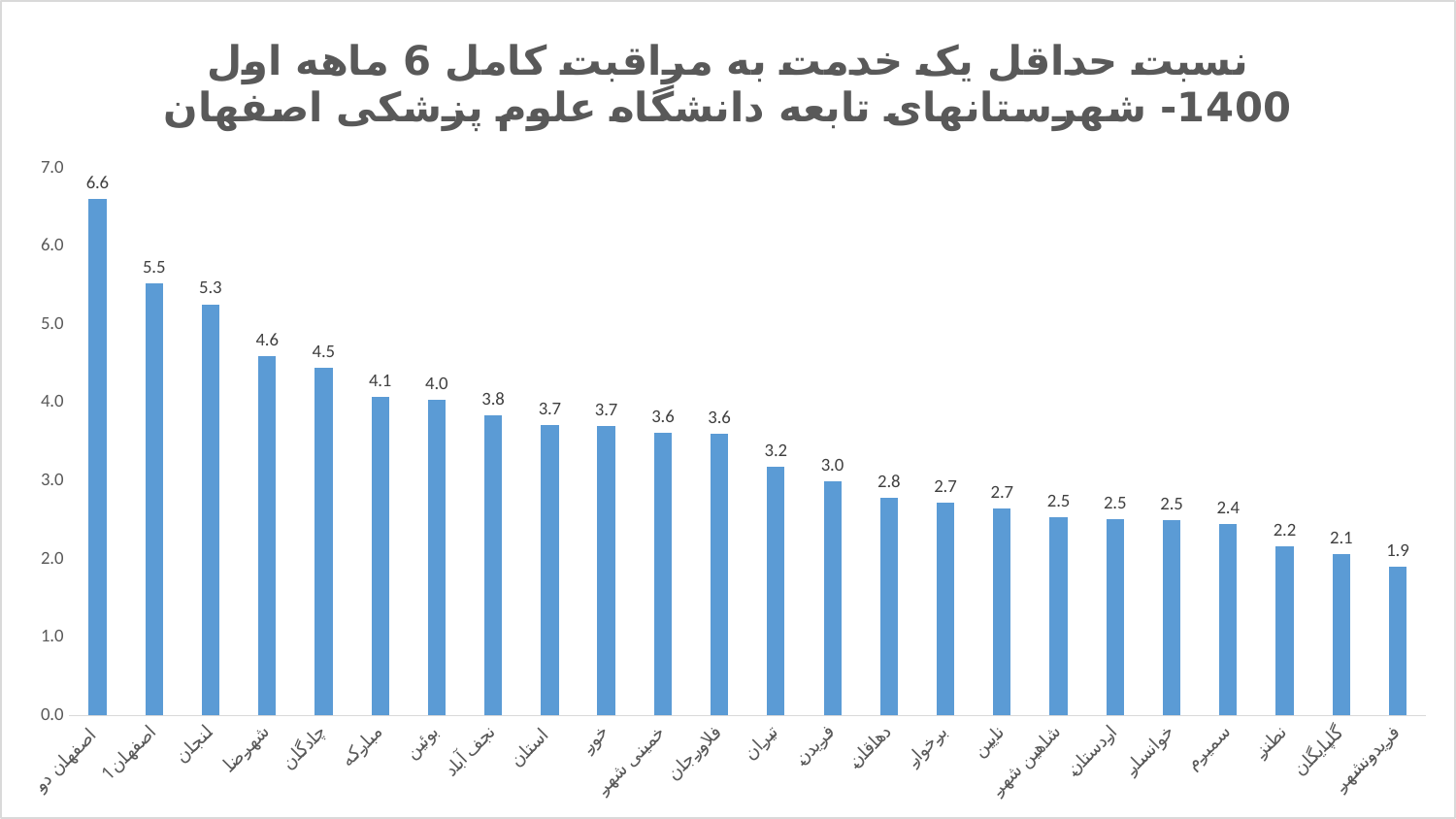
Is the value for چادگان greater or less than 4.0? greater Which has a larger value, مبارکه or فریدن? مبارکه What is the value for لنجان? 5.3 Do the values rise or fall from left to right along the x axis? fall Which category has the highest value? اصفهان دو What is the value for سمیرم? 2.4 How many categories are shown on the x axis? 24 What is the difference between the values for اصفهان دو and اصفهان 1? 1.1 Which category has the lowest value? فریدونشهر What is the value for نجف آباد? 3.8 What kind of chart is this? bar chart What is the difference between the values for شهرضا and تیران? 1.4